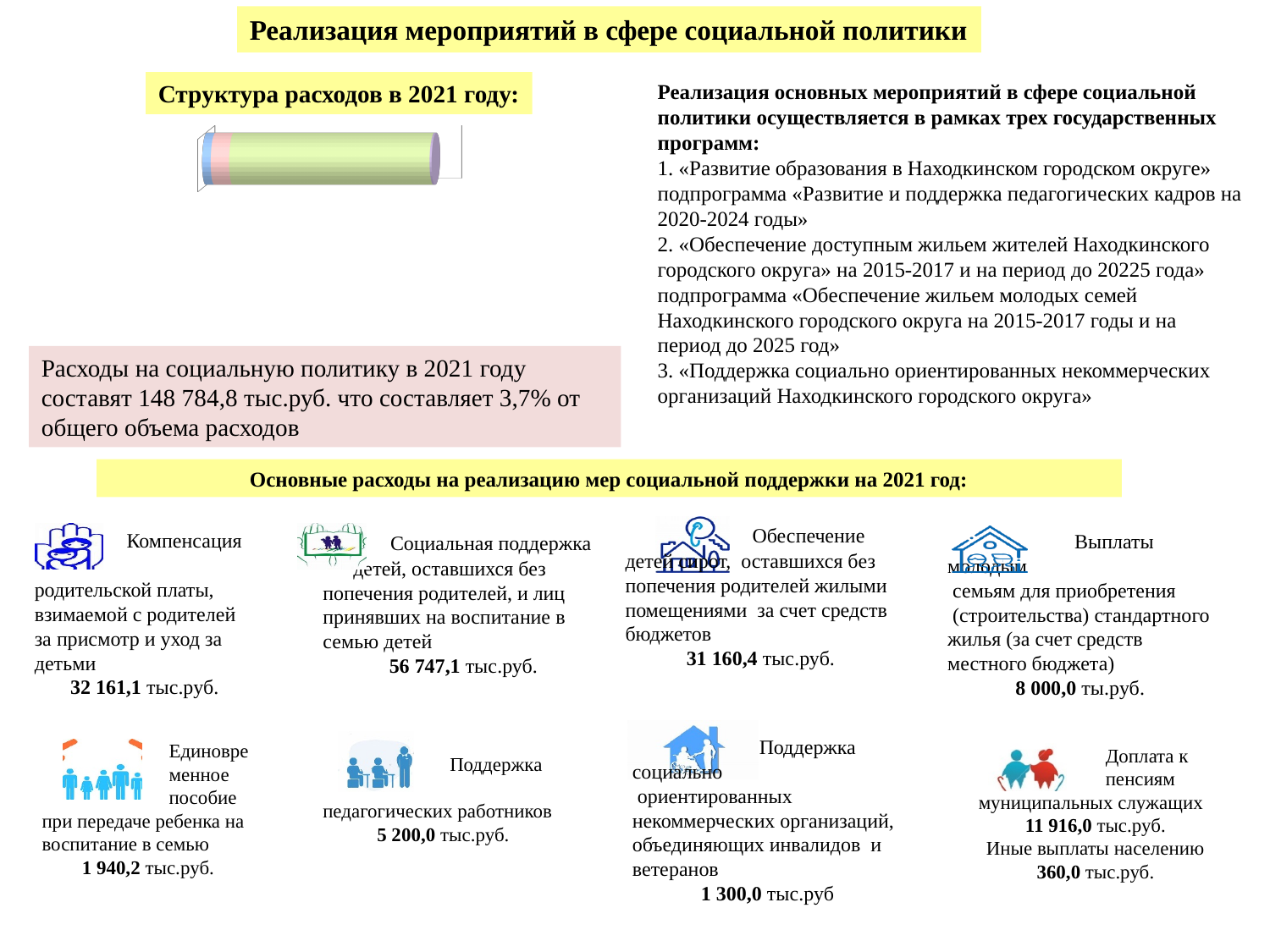
How many coloured segments does the stacked bar in the chart contain? 4 What kind of chart is shown under the heading "Структура расходов в 2021 году:"? bar chart What is the title above the chart on the left of the slide? Структура расходов в 2021 году: Does the chart display a legend? No Is the green segment of the stacked bar larger or smaller than the blue segment? larger Which coloured segment of the stacked bar is the largest? green